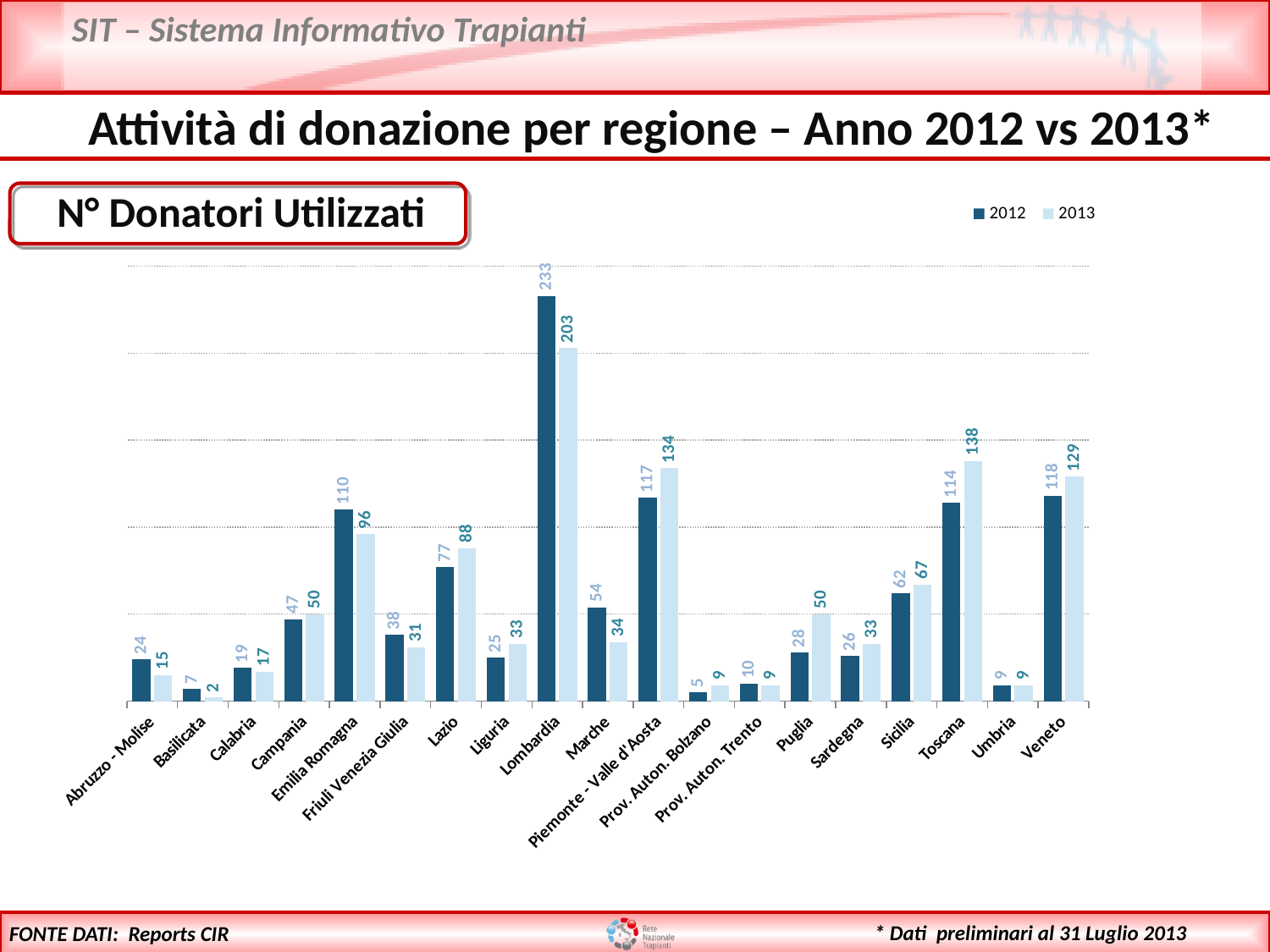
Which region has the highest value in 2013? Lombardia What kind of chart is shown on the slide? Bar chart Which is larger for Lazio: the 2012 value or the 2013 value? 2013 Which is larger for Emilia Romagna: the 2012 value or the 2013 value? 2012 How many regions are shown on the x axis of the chart? 19 What is the value for Toscana in 2013? 138 What is the difference between the 2012 and 2013 values for Lombardia? 30 What is the difference between the 2012 and 2013 values for Puglia? 22 What is the value for Piemonte - Valle d'Aosta in 2013? 134 Which region has the lowest value in 2012? Prov. Auton. Bolzano How many series does the legend list? 2 What is the value for Lombardia in 2012? 233